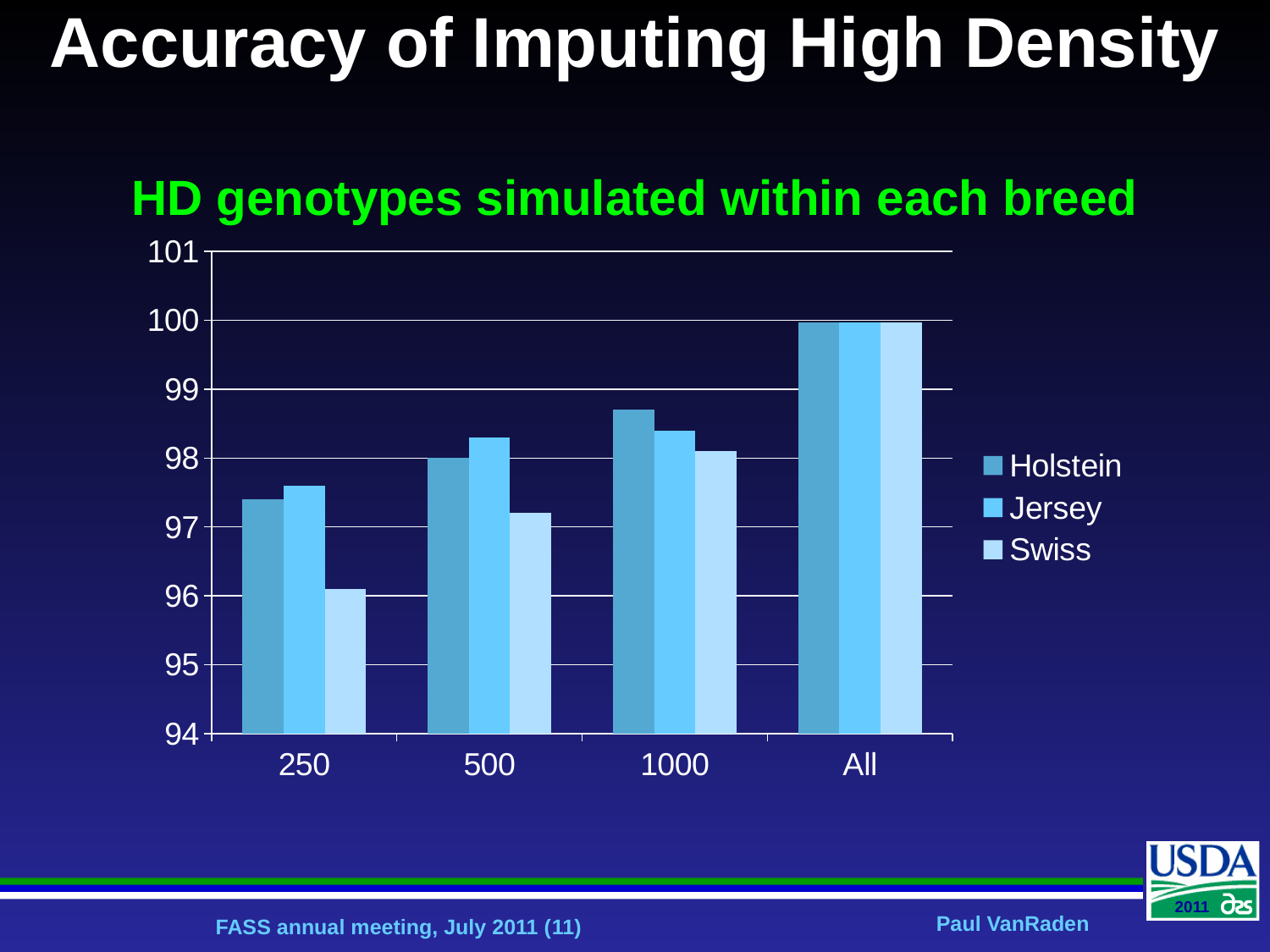
What kind of chart is shown on the slide? bar chart Is the Jersey value for 500 greater or less than 98? greater Which is larger, the Swiss value for 250 or the Swiss value for 500? 500 For the 250 category, which breed has the lowest value? Swiss For the 1000 category, which is larger, the Holstein value or the Swiss value? Holstein How many categories are shown on the x axis? 4 What is the title of the chart? HD genotypes simulated within each breed Which category has the highest Swiss value? All Is the Swiss value for 250 greater or less than 97? less How many series does the legend list? 3 Do the Holstein values rise or fall from 250 to All along the x axis? rise Is the Holstein value for 1000 greater or less than 98? greater